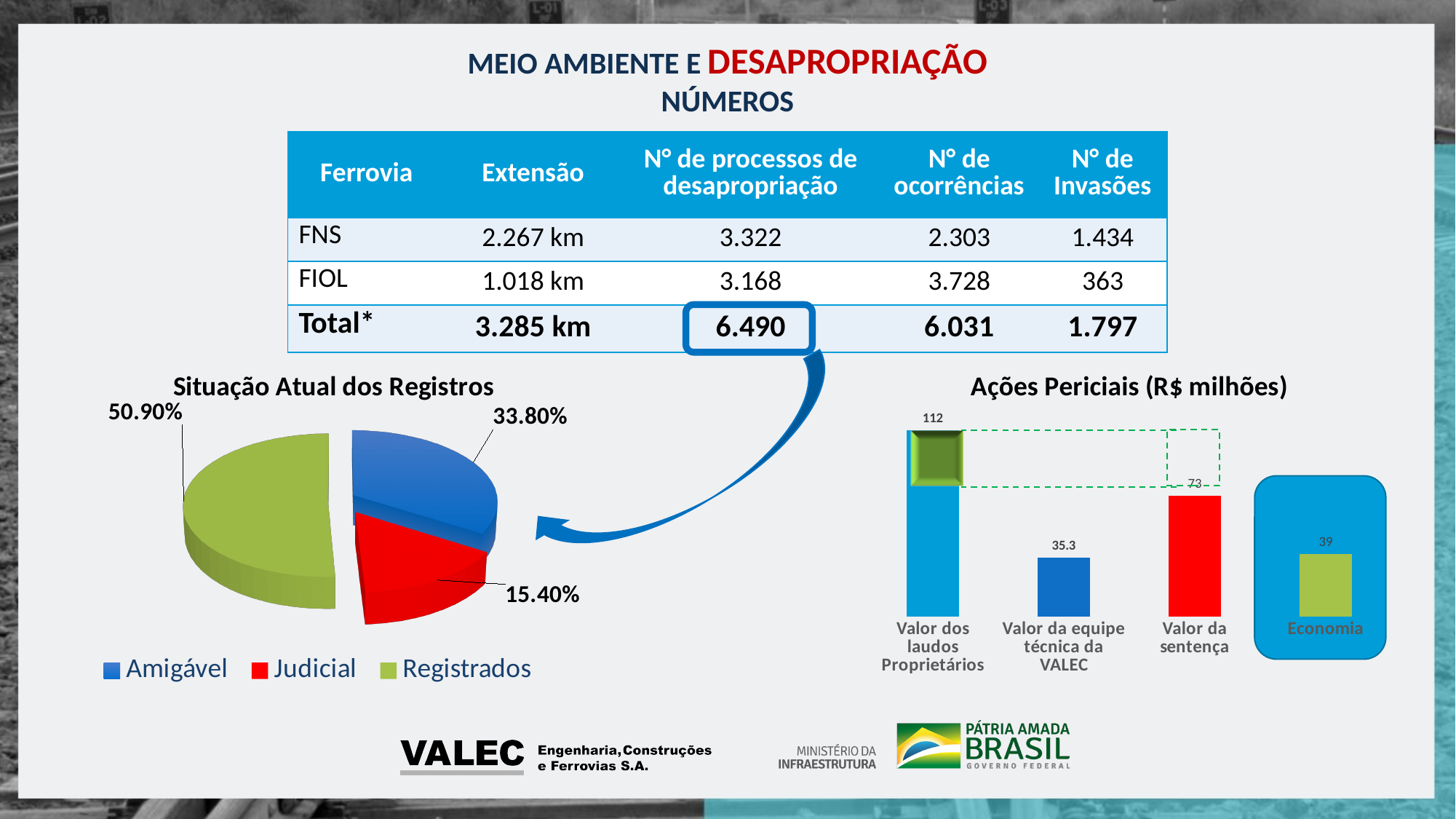
In the 'Ações Periciais (R$ milhões)' chart, what is the value for Valor da sentença? 73 In the 'Ações Periciais (R$ milhões)' chart, what is the difference between Valor dos laudos Proprietários and Valor da sentença? 39 In the 'Situação Atual dos Registros' chart, what share is labelled for Judicial? 15.40% In the 'Situação Atual dos Registros' chart, what share is labelled for Registrados? 50.90% What kind of chart is 'Situação Atual dos Registros'? Pie chart In the 'Ações Periciais (R$ milhões)' chart, what is the value for Valor da equipe técnica da VALEC? 35.3 In the 'Ações Periciais (R$ milhões)' chart, which category has the highest value? Valor dos laudos Proprietários In the 'Situação Atual dos Registros' chart, which category has the largest slice? Registrados In the 'Ações Periciais (R$ milhões)' chart, what is the value for Valor dos laudos Proprietários? 112 What kind of chart is 'Ações Periciais (R$ milhões)'? Bar chart In the 'Situação Atual dos Registros' chart, which category has the smallest slice? Judicial In the 'Situação Atual dos Registros' chart, how many entries does the legend list? 3